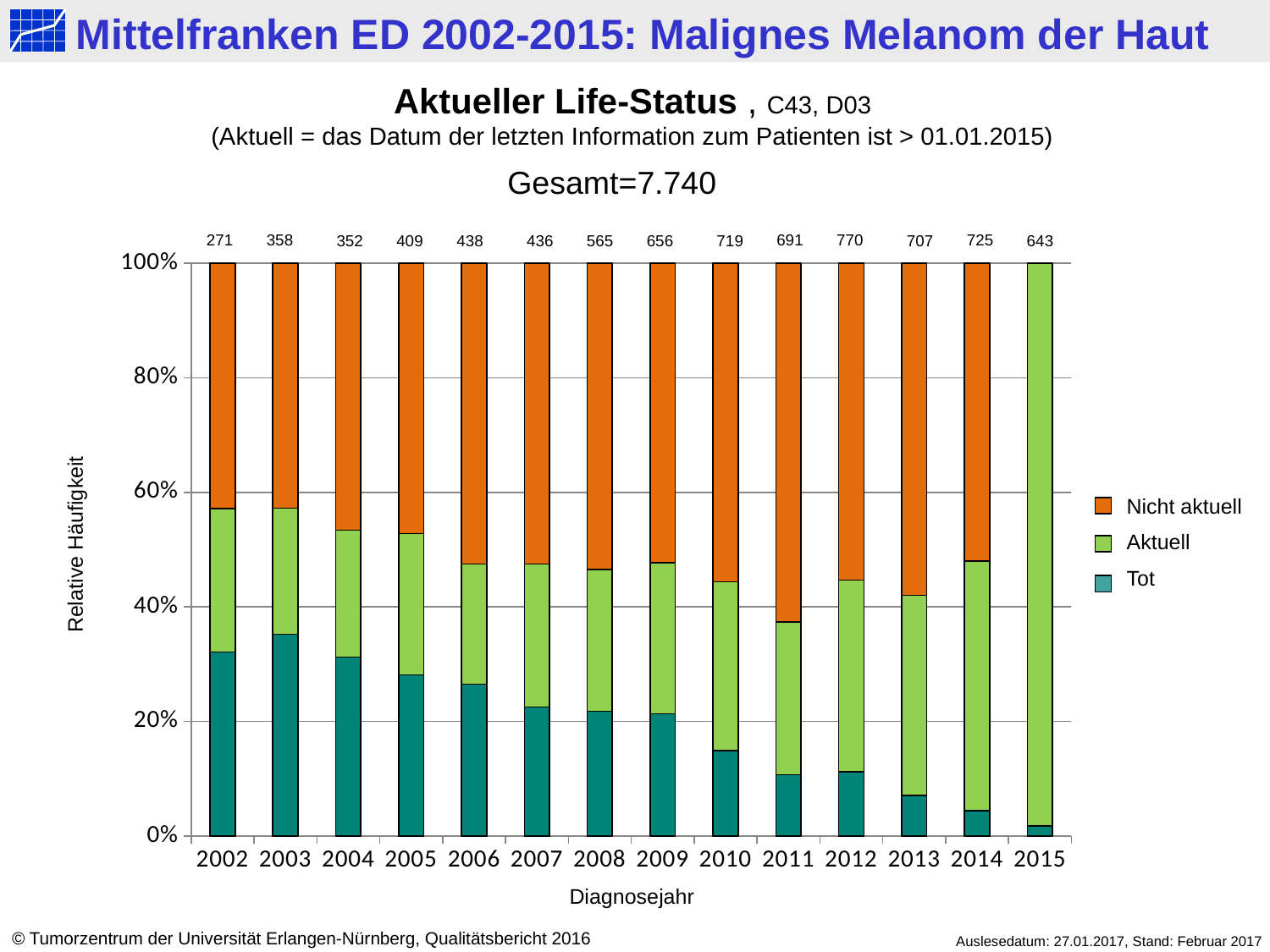
Is the 'Tot' share for 2002 greater or less than 20%? greater What number is printed above the bar for 2012? 770 How many series does the legend list? 3 What number is printed above the bar for 2002? 271 What number is printed above the bar for 2015? 643 What is the difference between the numbers printed above the bars for 2012 and 2002? 499 Which diagnosis year has the highest number printed above its bar? 2012 Which diagnosis year has the lowest number printed above its bar? 2002 Which year has the larger number printed above its bar, 2010 or 2011? 2010 Is the 'Tot' share for 2015 greater or less than 20%? less How many diagnosis years are shown on the x axis? 14 What kind of chart is shown on the slide? Stacked bar chart